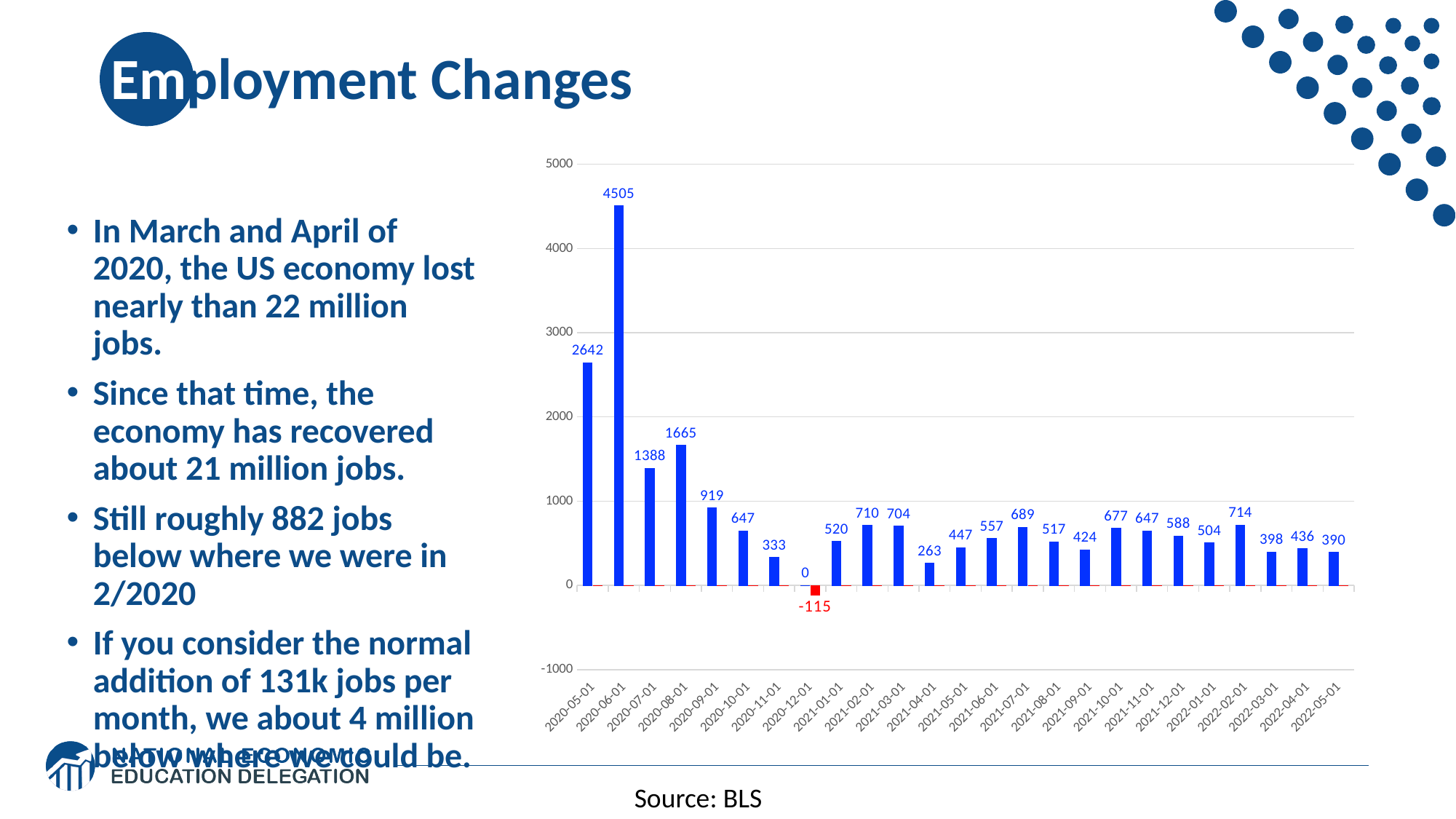
Is the value for 2020-09-01 greater or less than 1000? less Which month has the lowest value? 2020-12-01 Do the values rise or fall from 2020-06-01 to 2020-11-01? fall Which month has the highest value? 2020-06-01 How many months are plotted on the x axis? 25 What is the value for 2020-06-01? 4505 What type of chart is shown on the slide? Bar chart What is the difference between the values for 2020-06-01 and 2020-05-01? 1863 What is the value for 2021-04-01? 263 What is the difference between the values for 2020-08-01 and 2020-07-01? 277 What is the value for 2022-02-01? 714 Which is larger, the value for 2021-07-01 or the value for 2021-09-01? 2021-07-01